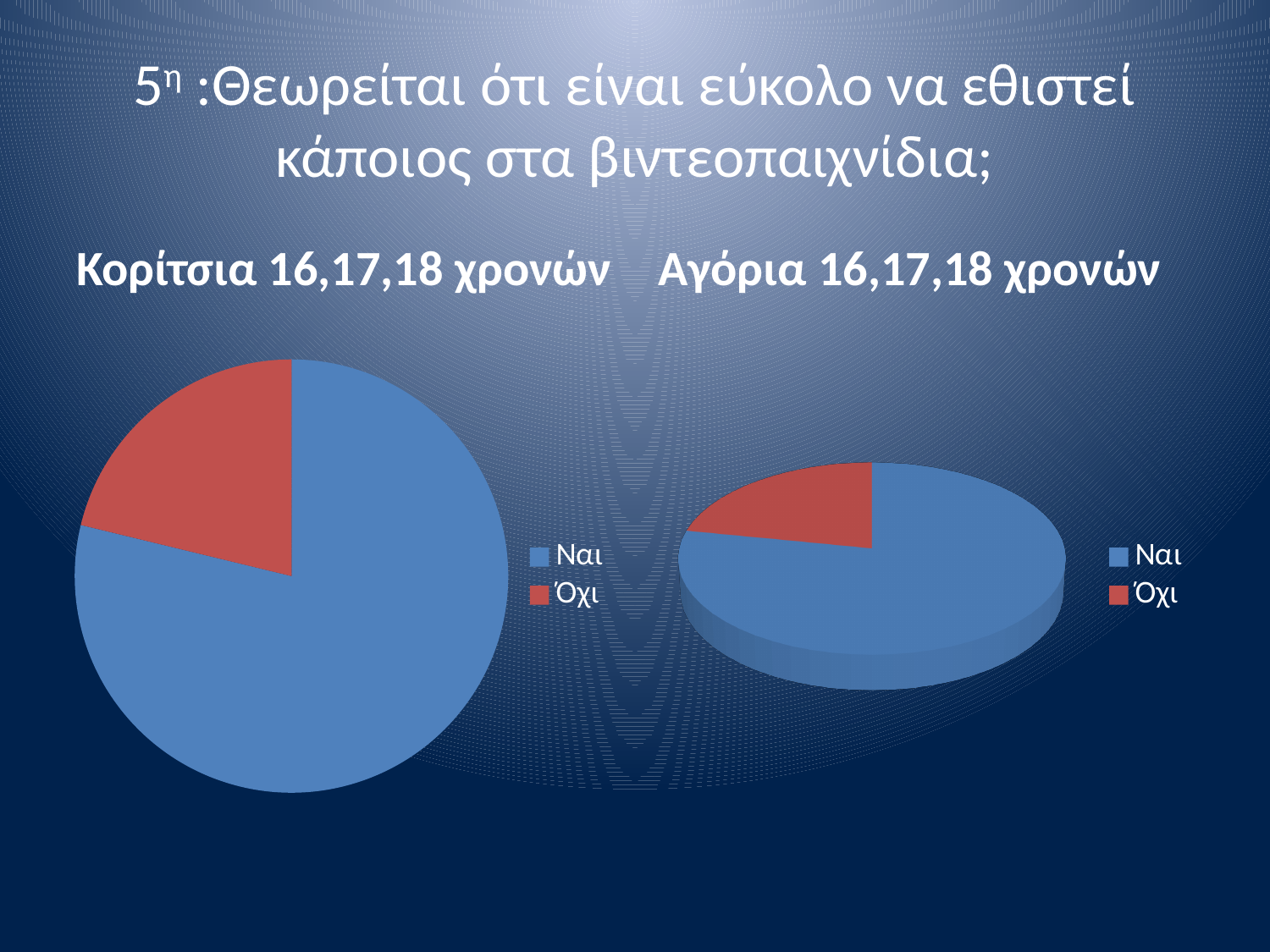
How many slices does the "Κορίτσια 16,17,18 χρονών" pie chart have? 2 What is the title of the pie chart on the left of the slide? Κορίτσια 16,17,18 χρονών In the "Κορίτσια 16,17,18 χρονών" chart, which slice is the largest? Ναι What kind of chart is the "Αγόρια 16,17,18 χρονών" chart? Pie chart In the "Αγόρια 16,17,18 χρονών" chart, which slice is the smallest? Όχι In the "Αγόρια 16,17,18 χρονών" chart, what colour is the Όχι slice? Red In the "Κορίτσια 16,17,18 χρονών" chart, which slice is the smallest? Όχι In the "Κορίτσια 16,17,18 χρονών" chart, which is larger, the Ναι slice or the Όχι slice? Ναι In the "Αγόρια 16,17,18 χρονών" chart, which slice is the largest? Ναι What kind of chart is the "Κορίτσια 16,17,18 χρονών" chart? Pie chart How many entries does the legend of the "Αγόρια 16,17,18 χρονών" chart list? 2 In the "Αγόρια 16,17,18 χρονών" chart, which is larger, the Ναι slice or the Όχι slice? Ναι